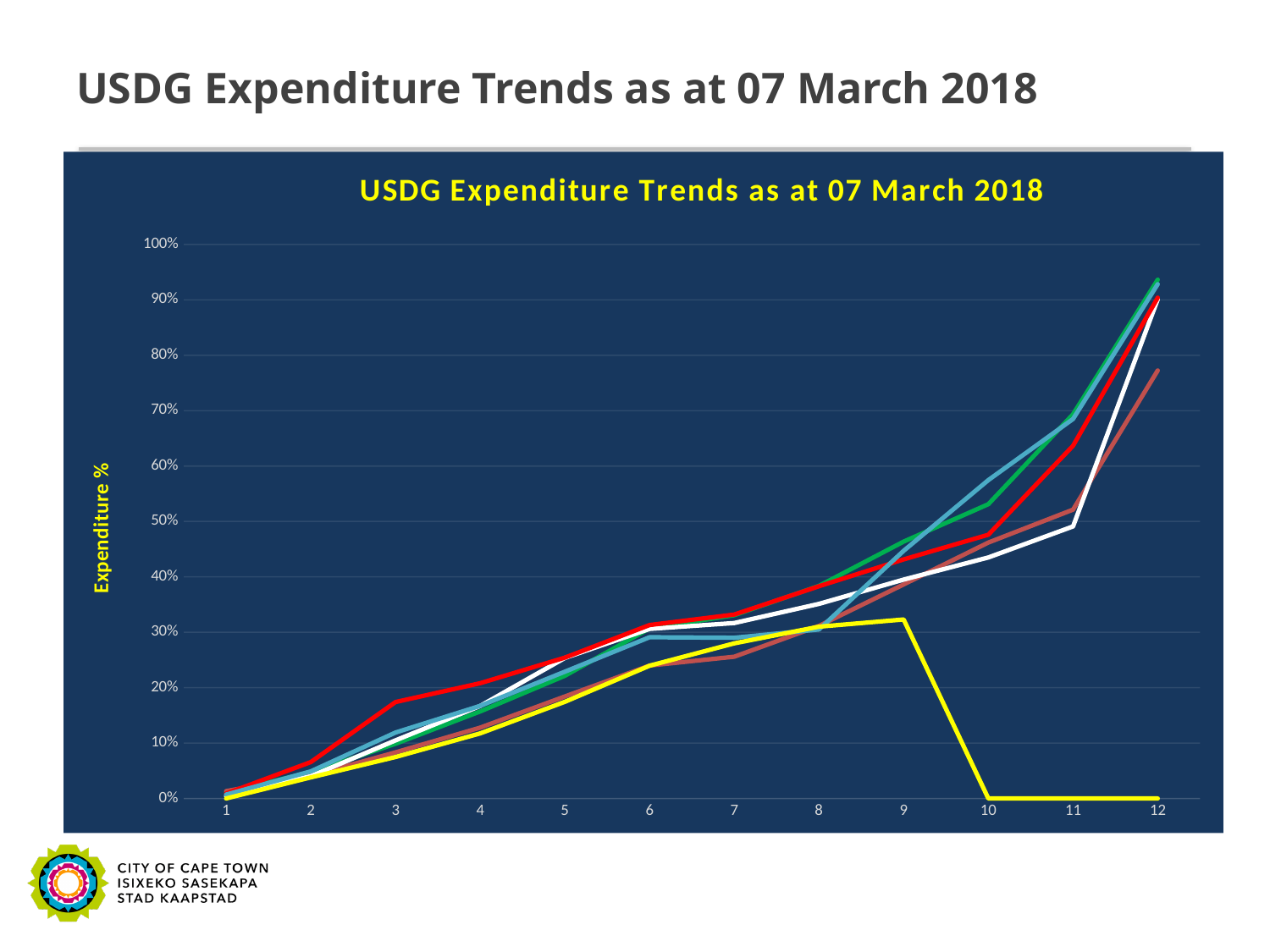
How many lines are plotted on the chart? 6 Does the yellow line rise or fall between x = 9 and x = 12? fall What is the label on the vertical axis of the chart? Expenditure % Does the green line rise or fall from x = 1 to x = 12? rise Which line has the lowest value at x = 12? the yellow line What is the title of the chart? USDG Expenditure Trends as at 07 March 2018 How many points are marked along the x axis of the chart? 12 Is the value of the green line at x = 12 greater or less than 90%? greater Is the value of the yellow line at x = 9 greater or less than 30%? greater What is the value of the yellow line at x = 12? 0% What kind of chart is shown on the slide? line chart Is the value of the brown line at x = 12 greater or less than 80%? less